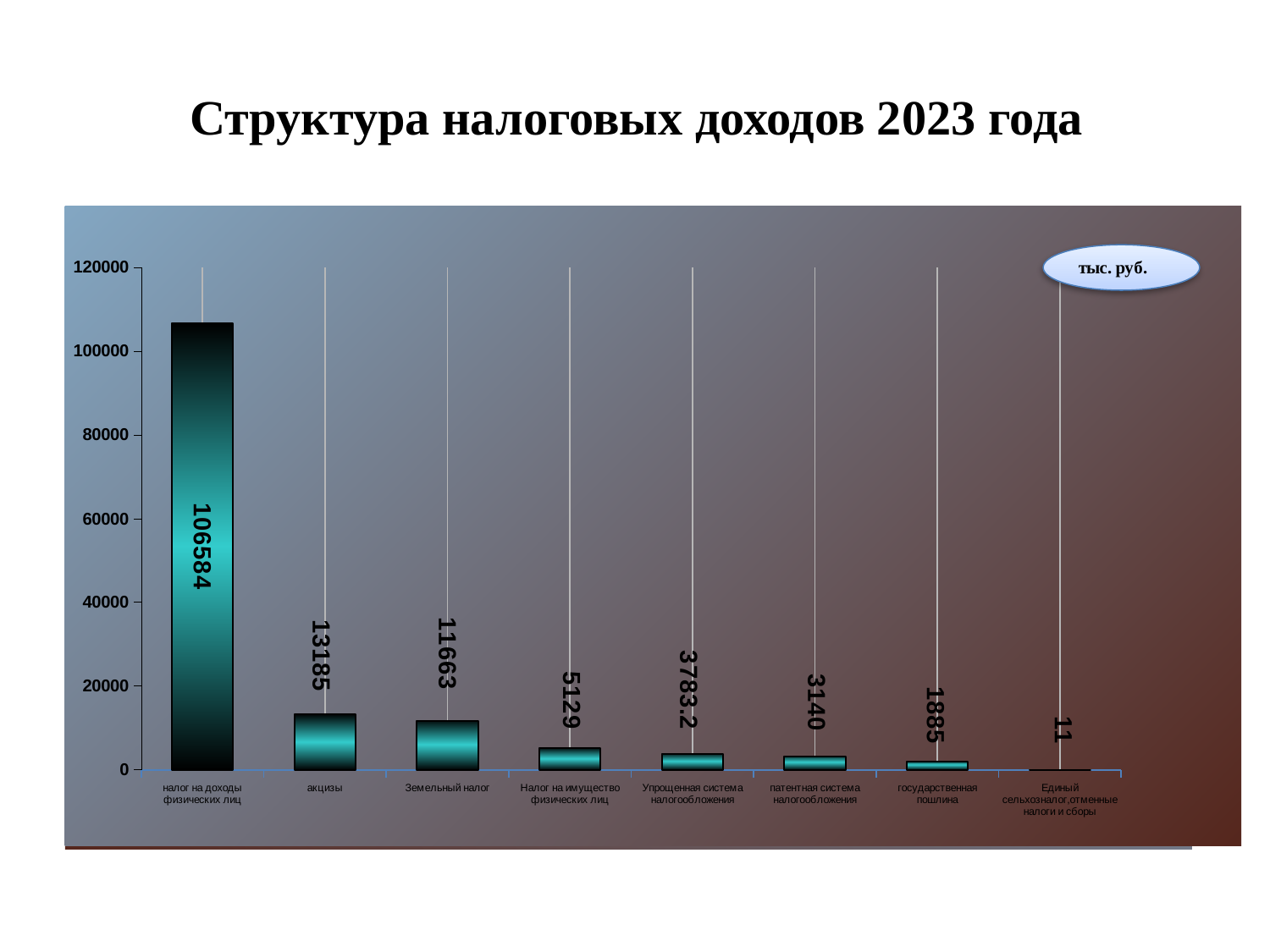
How many categories are shown in the chart? 8 Is the value for налог на доходы физических лиц greater or less than 100000? greater What is the value for акцизы? 13185 Which category has the highest value? налог на доходы физических лиц Which is larger, the value for Налог на имущество физических лиц or the value for патентная система налогообложения? Налог на имущество физических лиц What is the difference between the values for акцизы and Земельный налог? 1522 What unit of measurement is indicated on the chart? тыс. руб. What is the value for налог на доходы физических лиц? 106584 What is the value for Упрощенная система налогообложения? 3783.2 What is the value for государственная пошлина? 1885 What kind of chart is shown on the slide? bar chart Which category has the lowest value? Единый сельхозналог,отменные налоги и сборы